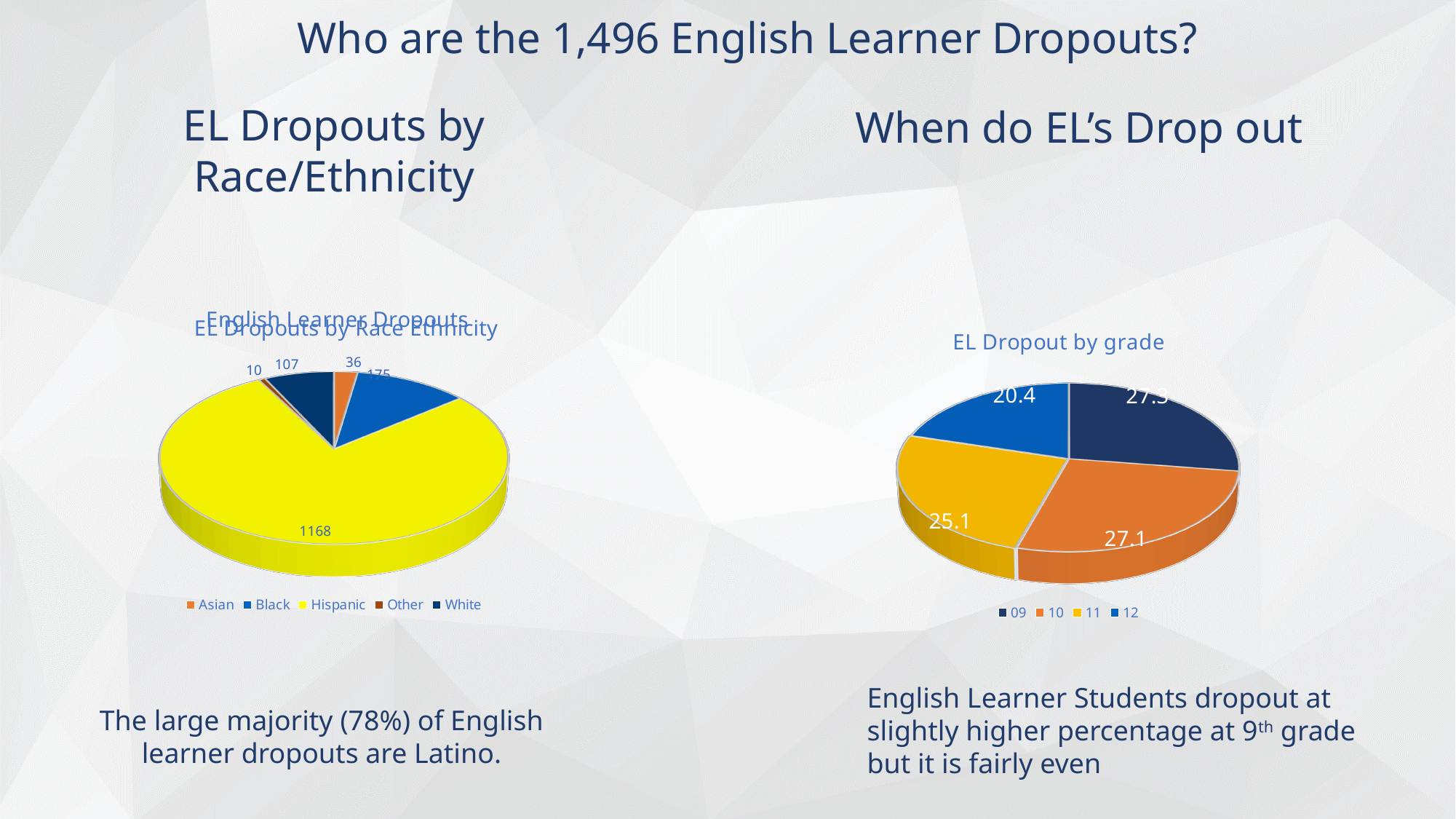
In the left pie chart (EL Dropouts by Race/Ethnicity), what is the value for Black? 175 In the chart titled 'EL Dropout by grade', what is the value for grade 09? 27.3 In the chart titled 'EL Dropout by grade', what is the difference between the values for grade 11 and grade 12? 4.7 What kind of chart is the chart titled 'EL Dropout by grade'? Pie chart In the left pie chart (EL Dropouts by Race/Ethnicity), what is the difference between the Black and White values? 68 In the left pie chart (EL Dropouts by Race/Ethnicity), which category has the smallest value? Other In the left pie chart (EL Dropouts by Race/Ethnicity), which category has the largest value? Hispanic In the chart titled 'EL Dropout by grade', what is the value for grade 12? 20.4 How many categories does the left pie chart (EL Dropouts by Race/Ethnicity) show? 5 In the left pie chart (EL Dropouts by Race/Ethnicity), which is larger, the value for Black or the value for White? Black In the chart titled 'EL Dropout by grade', which grade has the lowest value? 12 In the left pie chart (EL Dropouts by Race/Ethnicity), what is the value for Hispanic? 1168